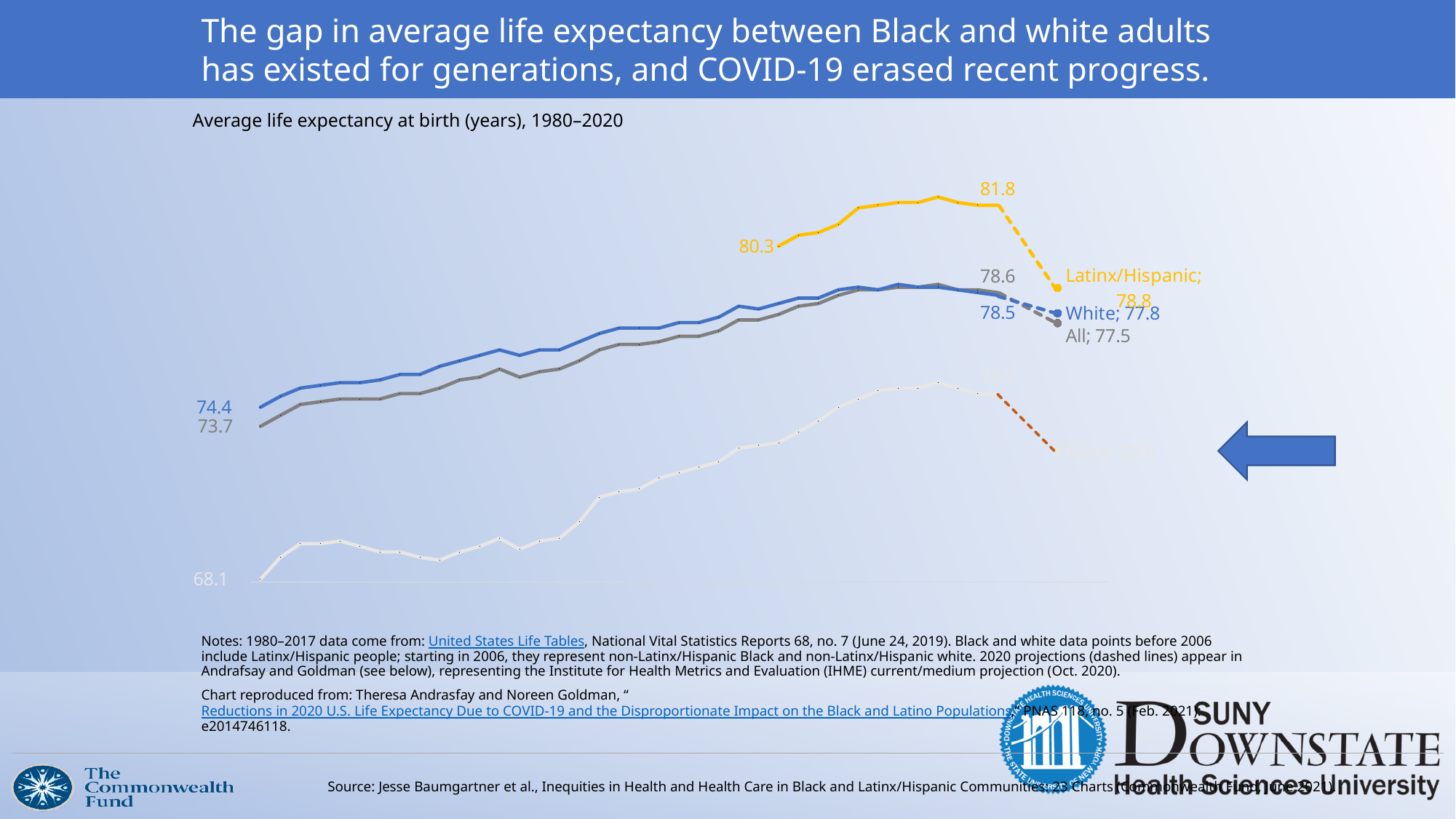
By how much does the Latinx/Hispanic line fall from its labelled peak of 81.8 to its 2020 projection of 78.8? 3.0 What is the subtitle describing what the chart measures? Average life expectancy at birth (years), 1980–2020 What is the 2020 projected life expectancy for the All group? 77.5 What is the first labelled value of the Latinx/Hispanic line? 80.3 Does the Latinx/Hispanic line rise or fall between its 81.8 label and its 2020 projection? fall Which group has the highest 2020 projected life expectancy? Latinx/Hispanic What is the 2020 projected life expectancy for the White group? 77.8 What is the starting (1980) value of the White line? 74.4 What kind of chart is shown on the slide? line chart What is the difference between the 2020 projected values for White (77.8) and All (77.5)? 0.3 What is the starting (1980) value of the All line? 73.7 What is the 2020 projected life expectancy for the Latinx/Hispanic group? 78.8